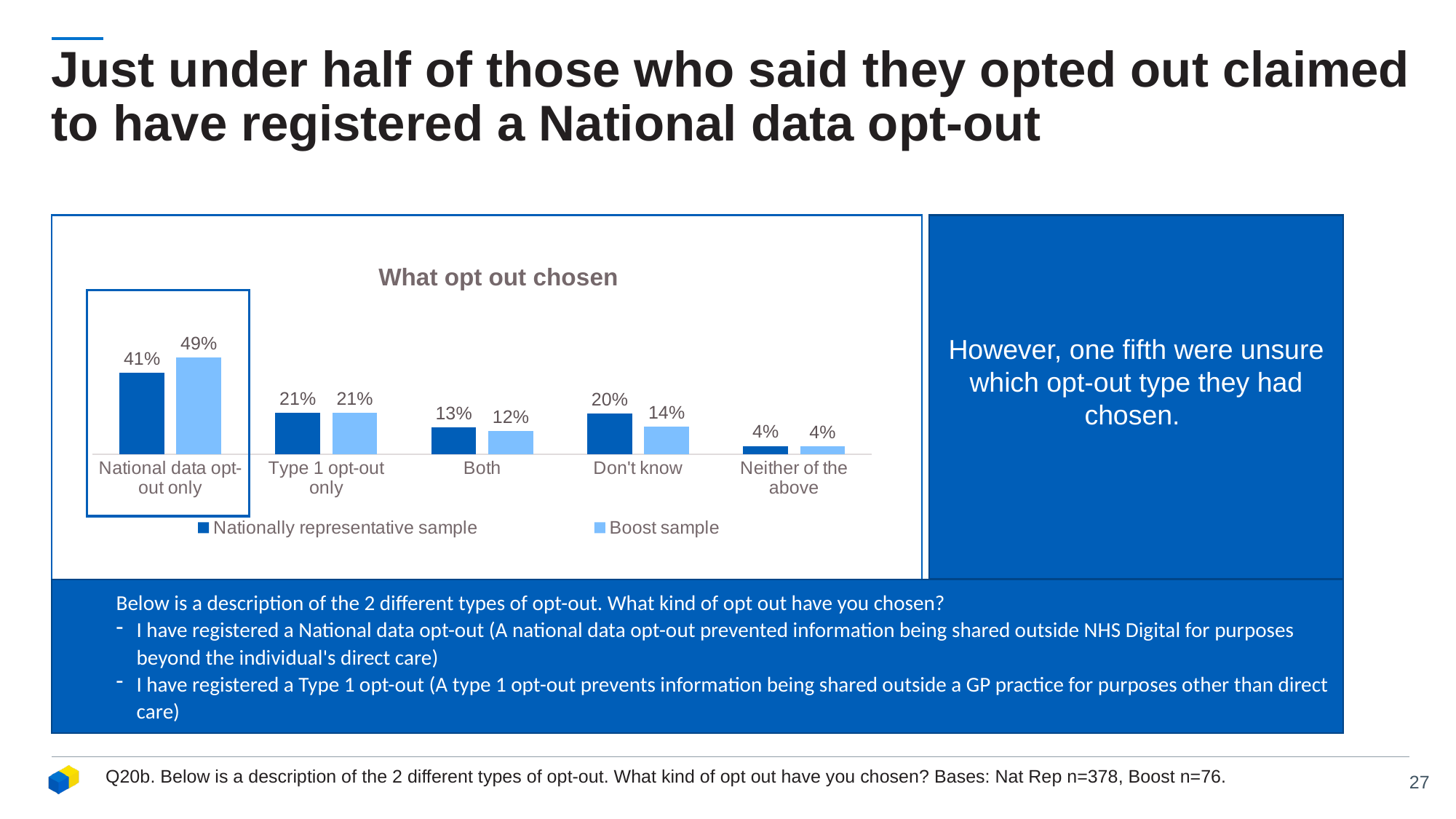
What is the value for 'National data opt-out only' in the Boost sample? 49% What is the value for 'National data opt-out only' in the Nationally representative sample? 41% What is the difference between the Boost sample and the Nationally representative sample for 'National data opt-out only'? 8 percentage points What is the value for 'Both' in the Nationally representative sample? 13% What is the title of the chart? What opt out chosen What kind of chart is shown? Bar chart How many categories are shown on the x axis? 5 How many series does the legend list? 2 Which category has the lowest value in the Boost sample? Neither of the above What is the value for 'Don't know' in the Boost sample? 14% Which is larger for 'Don't know': the Nationally representative sample or the Boost sample? Nationally representative sample Which category has the highest value in the Nationally representative sample? National data opt-out only